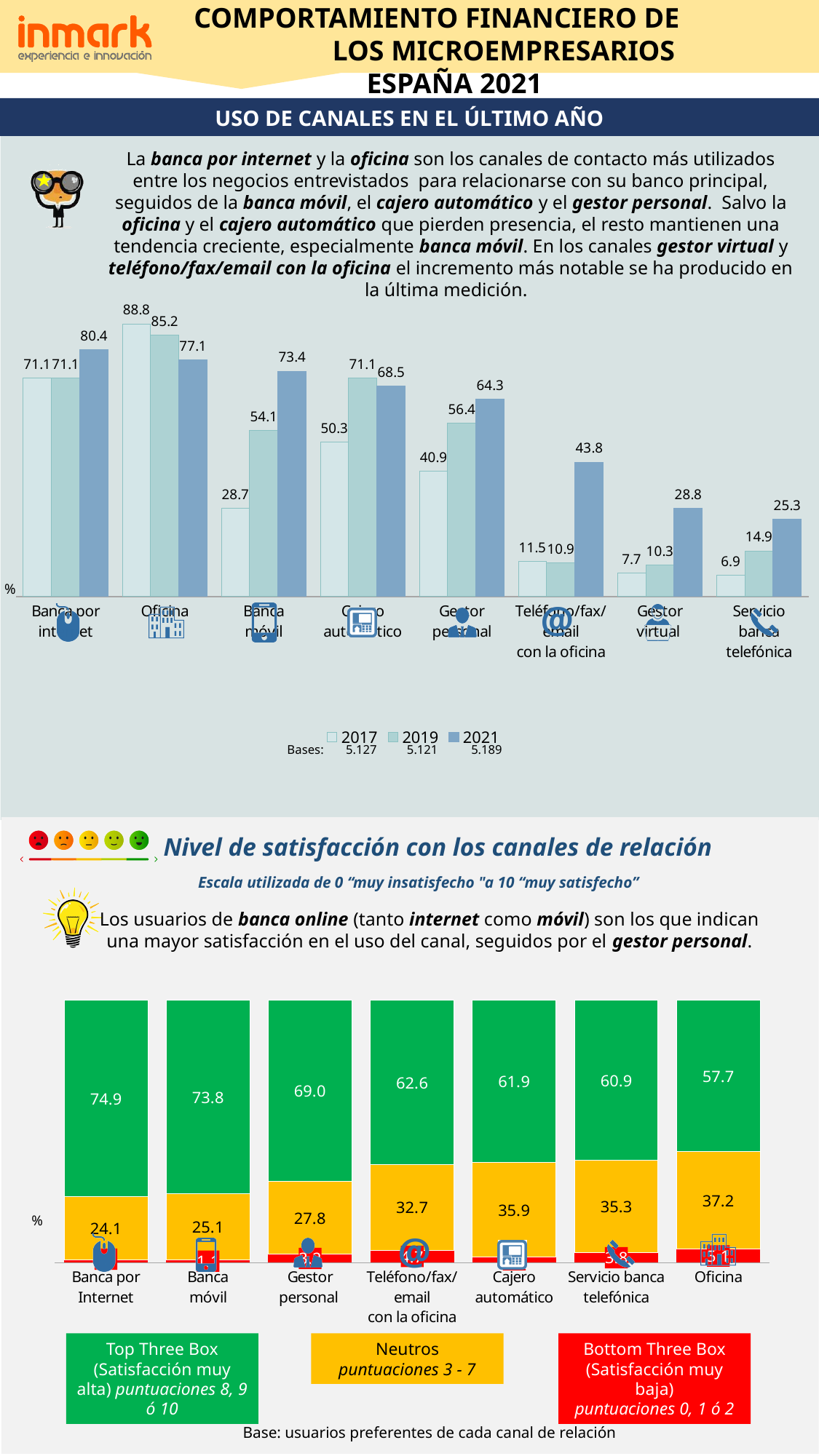
In the 'Uso de canales en el último año' chart, how many channels are shown on the x axis? 8 In the 'Uso de canales en el último año' chart, which is larger for Cajero automático: the 2019 value or the 2021 value? 2019 In the 'Uso de canales en el último año' chart, do the values for Gestor virtual rise or fall from 2017 to 2021? rise In the 'Nivel de satisfacción con los canales de relación' chart, what is the Top Three Box value for Gestor personal? 69.0 In the 'Nivel de satisfacción con los canales de relación' chart, which channel has the highest Top Three Box value? Banca por Internet In the 'Uso de canales en el último año' chart, what is the difference between the 2021 and 2019 values for Teléfono/fax/email con la oficina? 32.9 In the 'Uso de canales en el último año' chart, which channel has the lowest 2017 value? Servicio banca telefónica What kind of chart is the 'Nivel de satisfacción con los canales de relación' chart? stacked bar chart In the 'Uso de canales en el último año' chart, which channel has the highest 2021 value? Banca por internet In the 'Uso de canales en el último año' chart, what is the 2017 value for Oficina? 88.8 In the 'Uso de canales en el último año' chart, what is the 2021 value for Banca móvil? 73.4 In the 'Uso de canales en el último año' chart, how many series does the legend list? 3